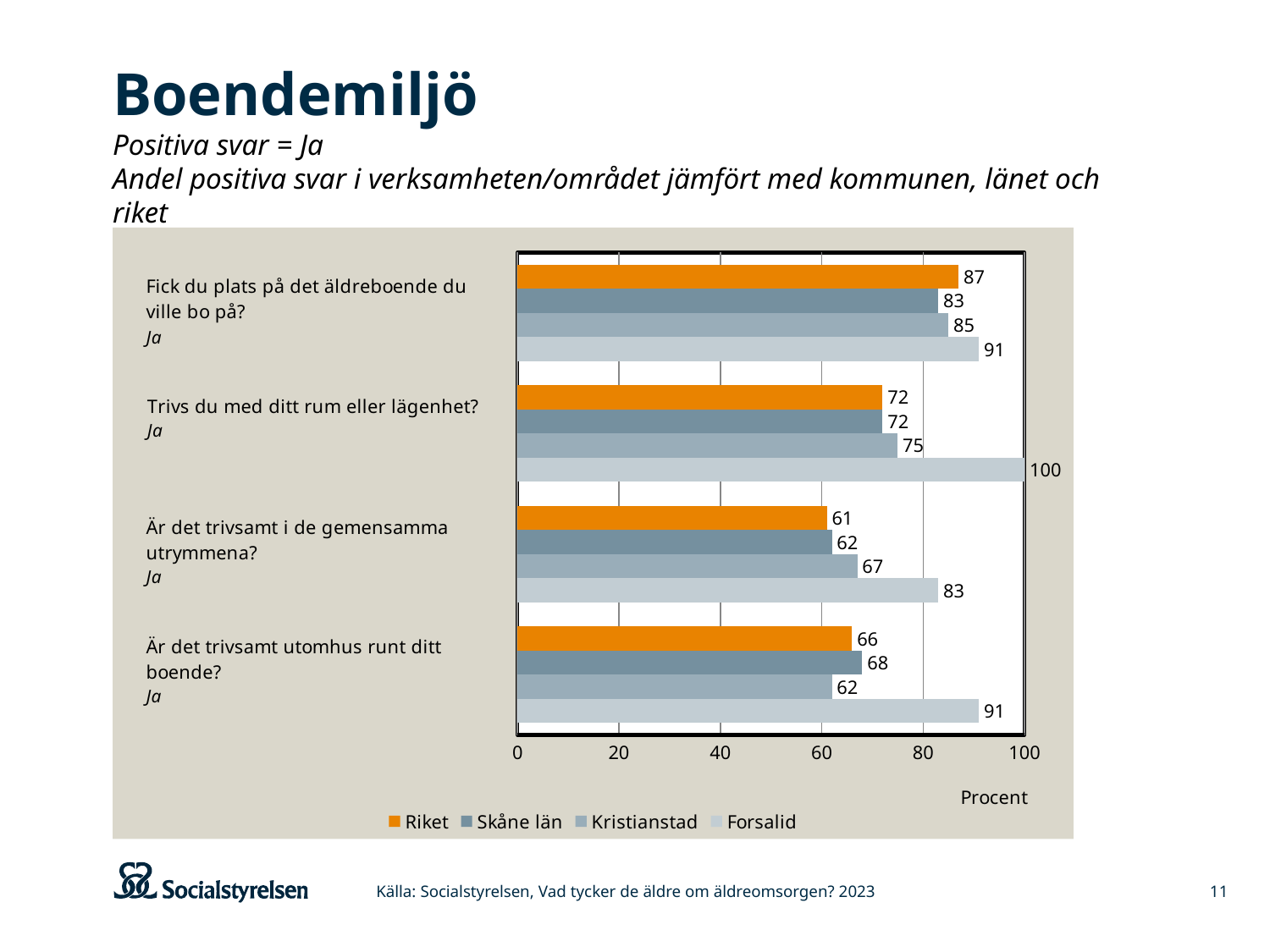
What kind of chart is shown on the slide? Bar chart What label is shown on the horizontal axis of the chart? Procent Which series has the highest value for "Är det trivsamt i de gemensamma utrymmena?"? Forsalid What is the value for Forsalid for "Trivs du med ditt rum eller lägenhet?"? 100 Which series has the lowest value for "Är det trivsamt utomhus runt ditt boende?"? Kristianstad What is the value for Kristianstad for "Är det trivsamt i de gemensamma utrymmena?"? 67 What is the value for Skåne län for "Är det trivsamt utomhus runt ditt boende?"? 68 What is the difference between Forsalid and Riket for "Är det trivsamt utomhus runt ditt boende?"? 25 What is the value for Riket for "Fick du plats på det äldreboende du ville bo på?"? 87 How many series does the legend list? 4 How many question categories are shown on the chart? 4 For "Fick du plats på det äldreboende du ville bo på?", which is larger: Skåne län or Kristianstad? Kristianstad